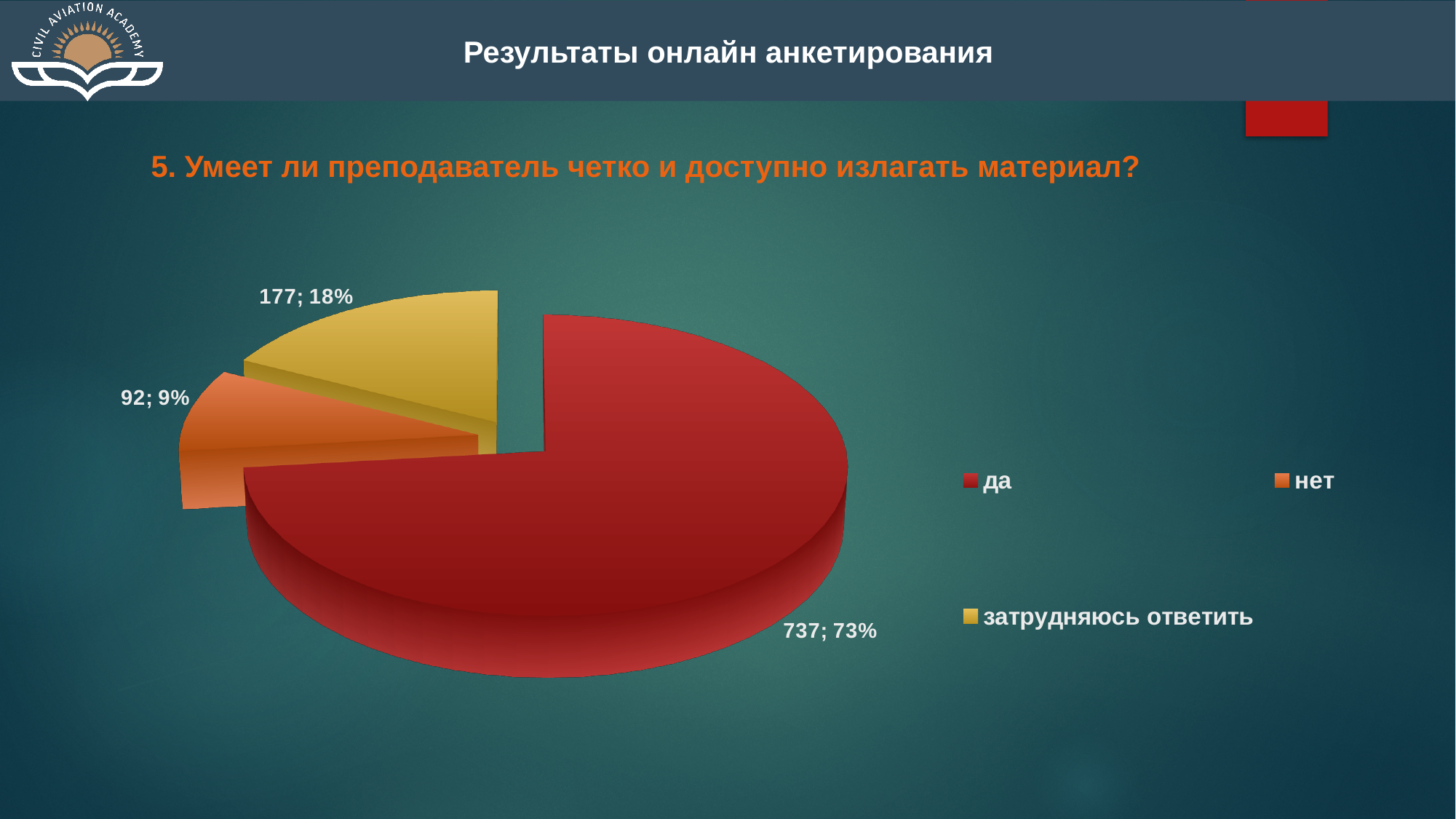
Which has more responses, "нет" or "затрудняюсь ответить"? затрудняюсь ответить What percentage share does the "нет" slice have? 9% What is the total number of responses across all three slices? 1006 What percentage share does the "да" slice have? 73% Which answer category has the smallest slice? нет What kind of chart is shown on the slide? pie chart What is the difference between the number of "да" responses and the number of "затрудняюсь ответить" responses? 560 How many categories does the pie chart have? 3 Which answer category has the largest slice? да How many respondents answered "да"? 737 What colour is the "затрудняюсь ответить" slice? yellow How many respondents answered "затрудняюсь ответить"? 177